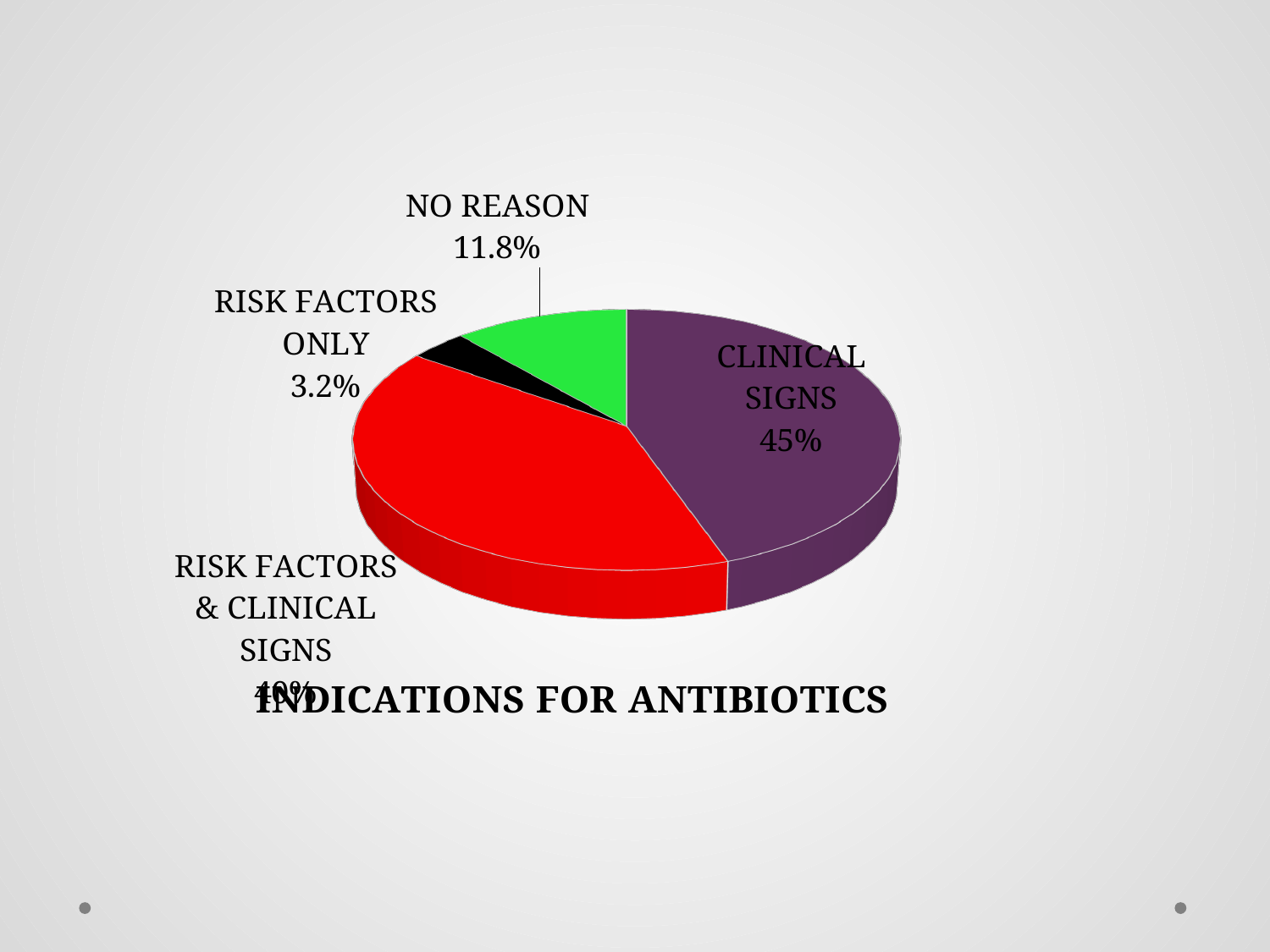
What is the difference in percentage points between NO REASON and RISK FACTORS ONLY? 8.6 percentage points Which is larger, RISK FACTORS & CLINICAL SIGNS or NO REASON? RISK FACTORS & CLINICAL SIGNS What percentage of the pie is CLINICAL SIGNS? 45% What is the title of the chart? INDICATIONS FOR ANTIBIOTICS What type of chart is shown on the slide? pie chart What percentage of the pie is RISK FACTORS ONLY? 3.2% What percentage of the pie is NO REASON? 11.8% Which is larger, NO REASON or RISK FACTORS ONLY? NO REASON How many slices does the pie chart have? 4 What is the difference in percentage points between CLINICAL SIGNS and NO REASON? 33.2 percentage points Which slice of the pie is the smallest? RISK FACTORS ONLY What colour is the CLINICAL SIGNS slice? purple